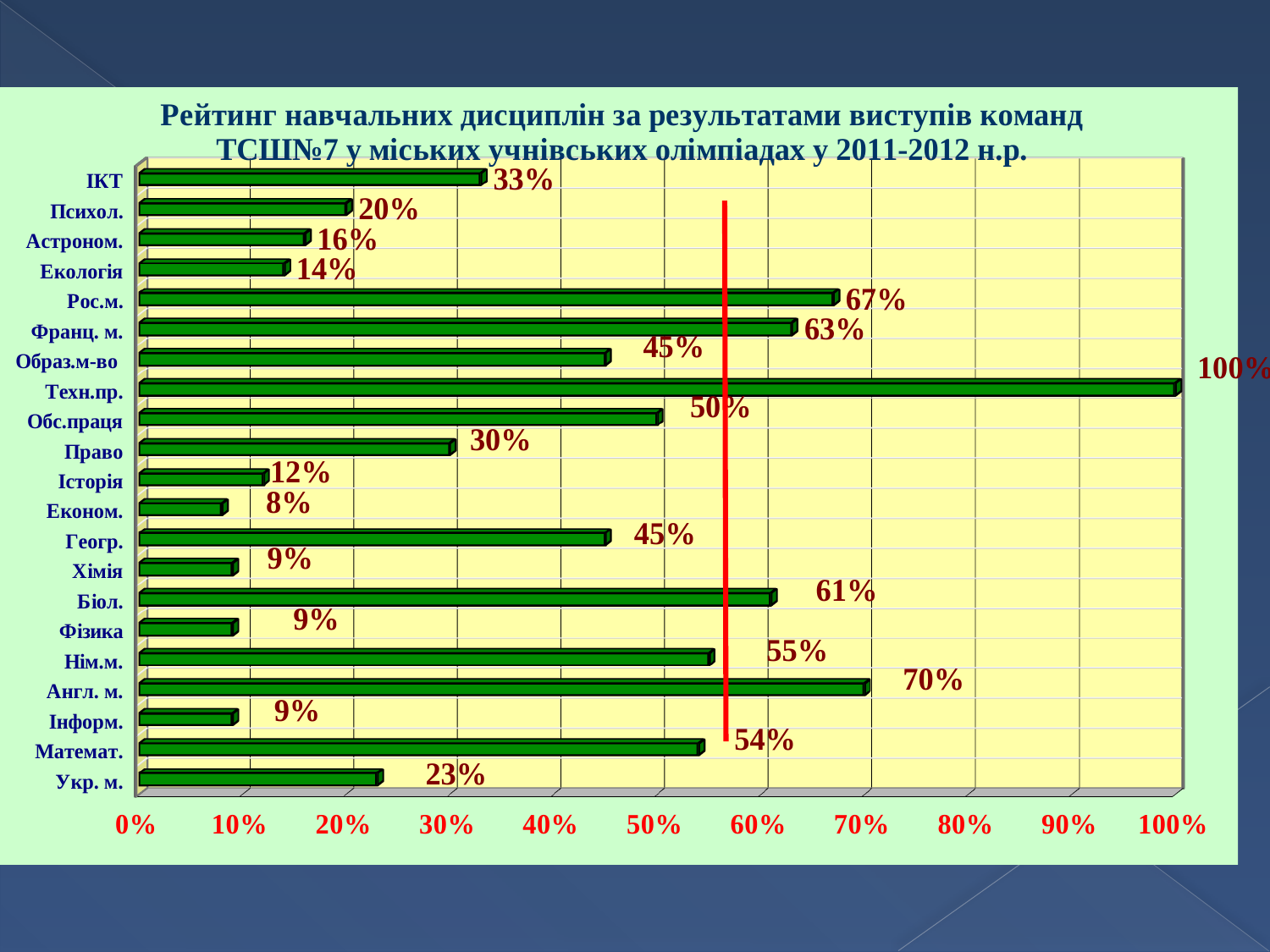
What is the value for Математ.? 54% Is the value for Обс.праця greater or less than 40%? greater What kind of chart is shown on the slide? bar chart Which is larger, the value for Біол. or the value for Нім.м.? Біол. What is the value for Англ. м.? 70% What is the value for Екологія? 14% What is the difference between the values for ІКТ and Укр. м.? 10% Which discipline has the lowest value? Економ. What is the difference between the values for Рос.м. and Франц. м.? 4% How many disciplines are shown on the chart? 21 What is the value for Техн.пр.? 100% Which discipline has the highest value? Техн.пр.